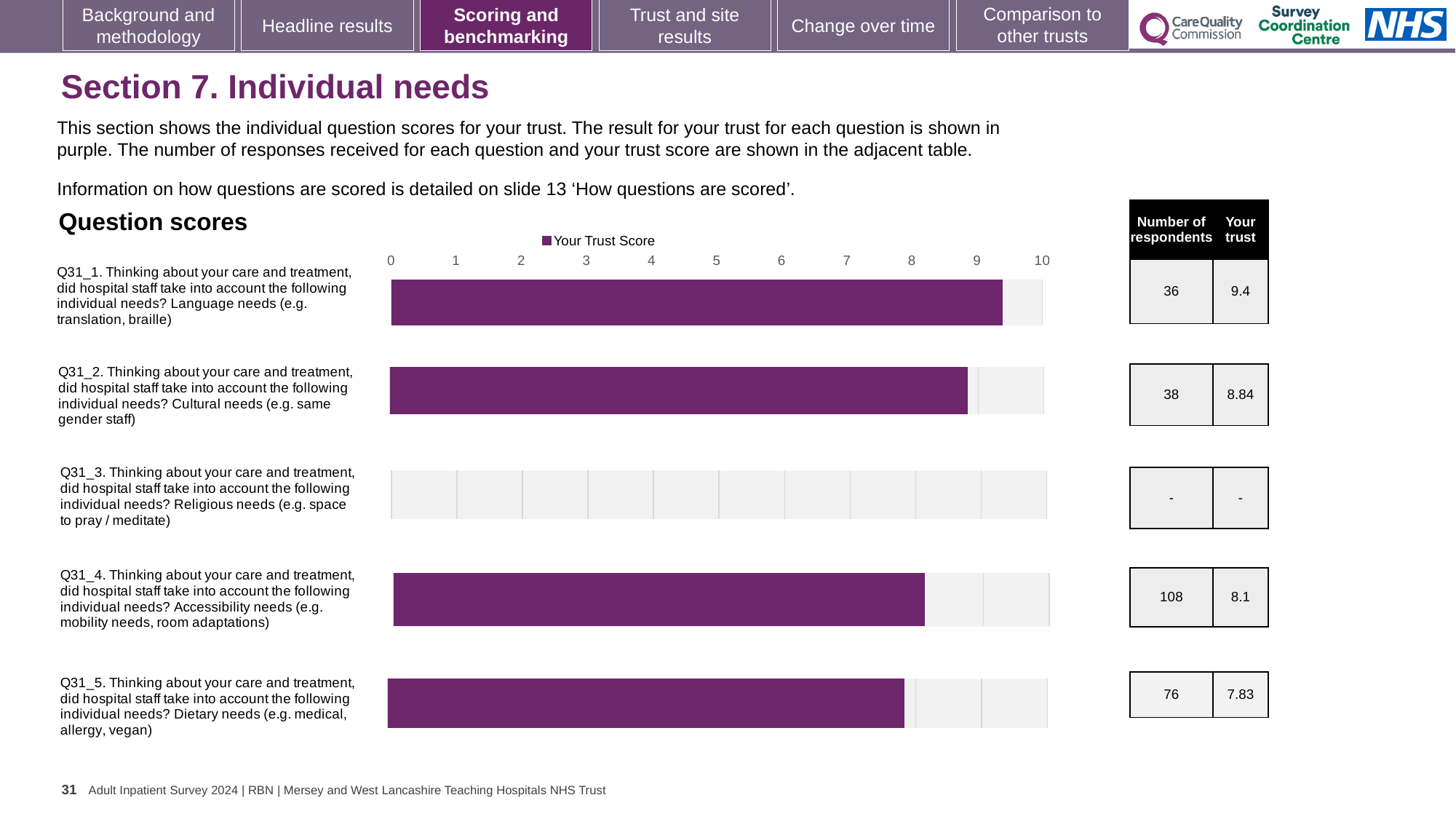
How many questions are listed in the chart? 5 Is the trust score for Q31_4 (Accessibility needs) greater or less than 9? less Which question has the highest trust score? Q31_1 (Language needs) What is the difference between the trust scores for Q31_1 and Q31_5? 1.57 How many respondents answered Q31_4 (Accessibility needs)? 108 Which question has no trust score shown? Q31_3 (Religious needs) Among the questions with a plotted score, which has the lowest trust score? Q31_5 (Dietary needs) What is the trust score for Q31_5 (Dietary needs)? 7.83 What type of chart is shown? Bar chart How many series does the legend list? 1 What is the trust score for Q31_1 (Language needs)? 9.4 Which has a higher trust score, Q31_2 (Cultural needs) or Q31_4 (Accessibility needs)? Q31_2 (Cultural needs)